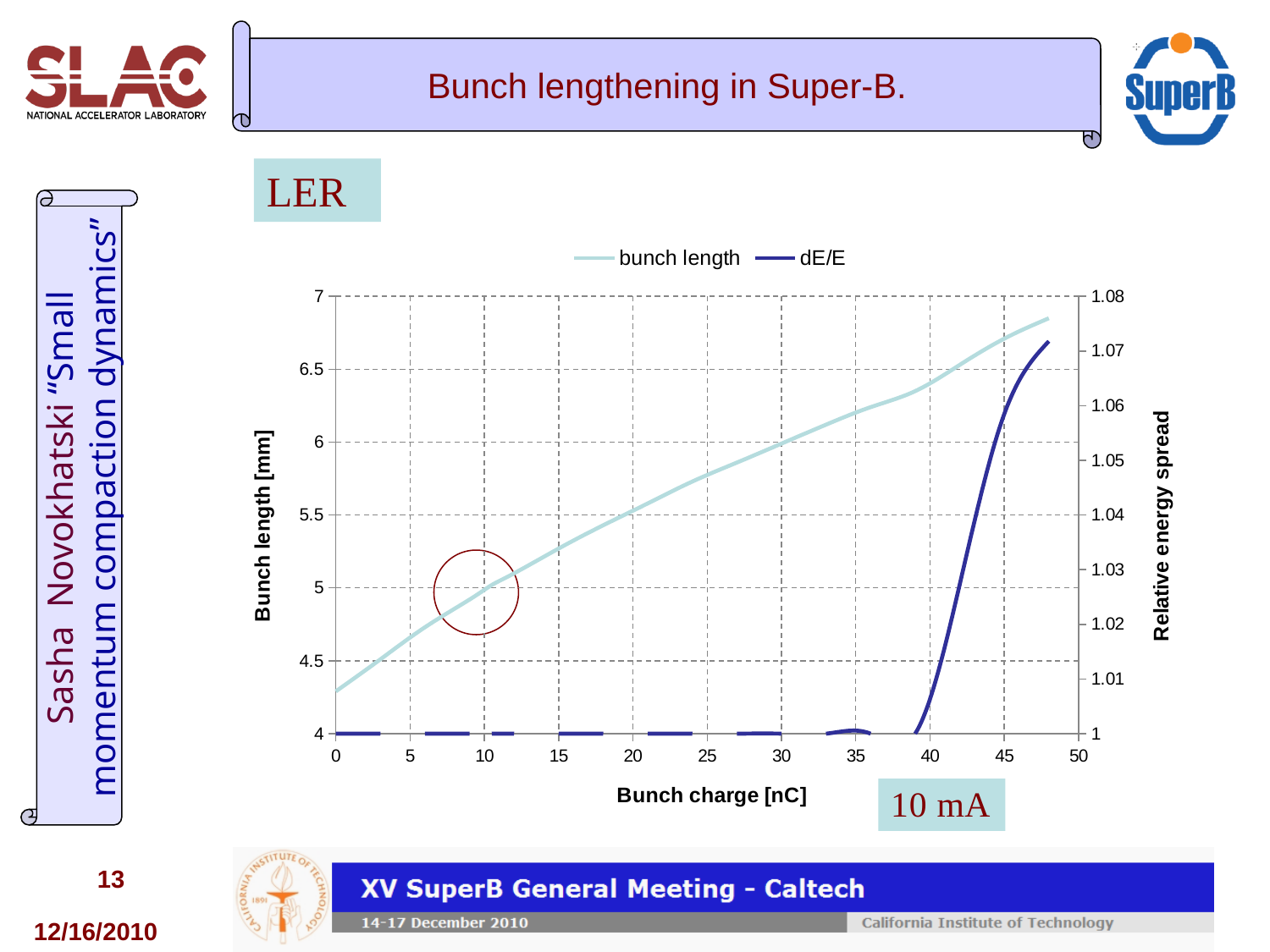
How many series does the chart legend list? 2 Is the bunch length at 30 nC greater or less than 5.5 mm? greater Is the bunch length at 45 nC greater or less than 6.5 mm? greater What is the label of the x axis of the chart? Bunch charge [nC] Is the dE/E value at 20 nC greater or less than 1.01? less What are the two series named in the chart legend? bunch length and dE/E Does the dE/E curve rise or fall between 40 nC and 48 nC? rise Is the bunch length larger at 40 nC or at 10 nC? 40 nC What kind of chart is shown on the slide? line chart Does the bunch length rise or fall as the bunch charge increases from 0 to 50 nC? rise